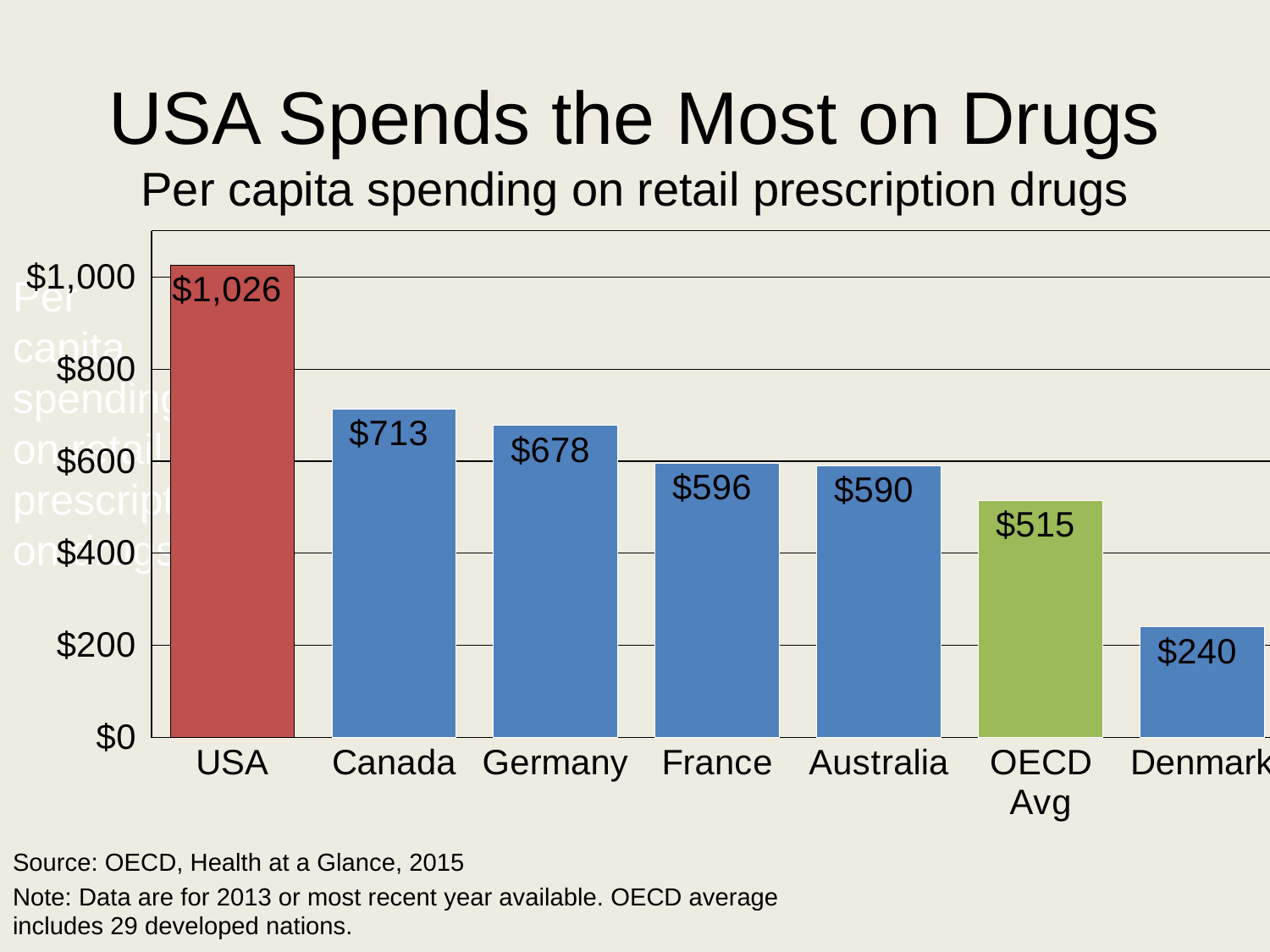
What is the value shown for the OECD Avg bar? $515 Which country has the highest per capita spending on retail prescription drugs? USA Which category has the lowest per capita spending on retail prescription drugs? Denmark What is the per capita spending on retail prescription drugs for the USA? $1,026 What is the difference between Germany's and France's per capita spending on retail prescription drugs? $82 How many bars are shown in the chart? 7 What is the per capita spending on retail prescription drugs for Denmark? $240 What colour is the bar for the OECD Avg? Green Which spends more per capita on retail prescription drugs, Germany or Australia? Germany What is the per capita spending on retail prescription drugs for Canada? $713 How much more does the USA spend per capita on retail prescription drugs than Canada? $313 What type of chart is shown on the slide? Bar chart